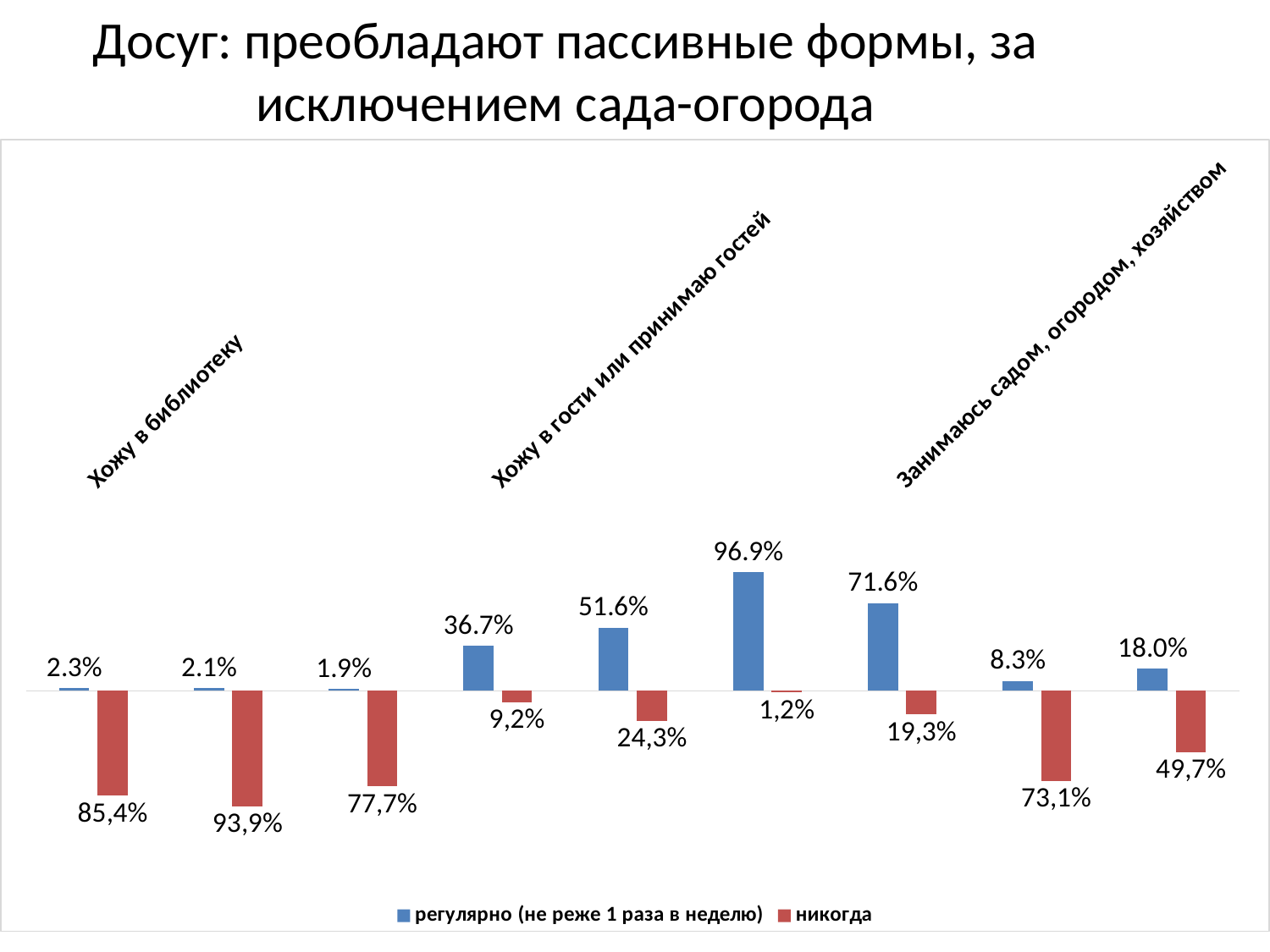
What is the highest value in the 'регулярно (не реже 1 раза в неделю)' series? 96.9% In the leftmost group of bars, which series has the larger value, 'регулярно' or 'никогда'? никогда How many series does the legend list? 2 What is the difference between the 'регулярно' values of 71.6% and 51.6%? 20.0% How many groups of bars are plotted in the chart? 9 What are the two series named in the legend? регулярно (не реже 1 раза в неделю) and никогда In the group where 'регулярно' is 96.9%, what is the value for 'никогда'? 1,2% What is the lowest value in the 'регулярно (не реже 1 раза в неделю)' series? 1.9% What is the title of the slide? Досуг: преобладают пассивные формы, за исключением сада-огорода What kind of chart is shown on the slide? bar chart What is the highest value in the 'никогда' series? 93,9% What is the lowest value in the 'никогда' series? 1,2%